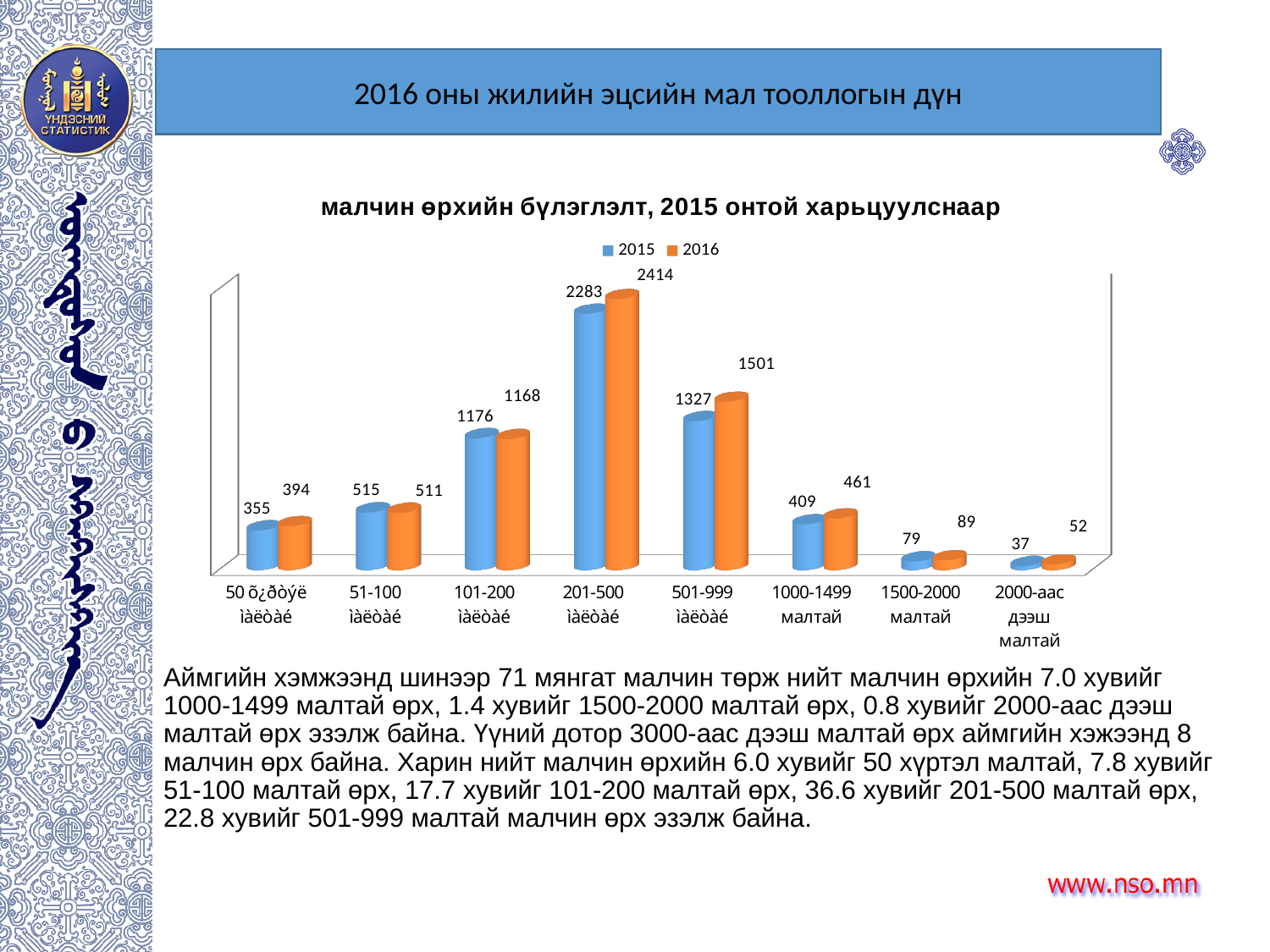
Which category has the lowest 2015 value? 2000-аас дээш малтай What is the 2016 value for the 201-500 category? 2414 How many series does the legend list? 2 What type of chart is shown on the slide? bar chart For the 51-100 category, which is larger, the 2015 value or the 2016 value? 2015 What is the 2015 value for the 501-999 category? 1327 Which category has the highest 2016 value? 201-500 What is the title of the chart? малчин өрхийн бүлэглэлт, 2015 онтой харьцуулснаар How many categories are shown on the x axis? 8 What is the difference between the 2016 and 2015 values for the 501-999 category? 174 What is the 2016 value for the 2000-аас дээш малтай category? 52 What is the 2015 value for the 1000-1499 малтай category? 409